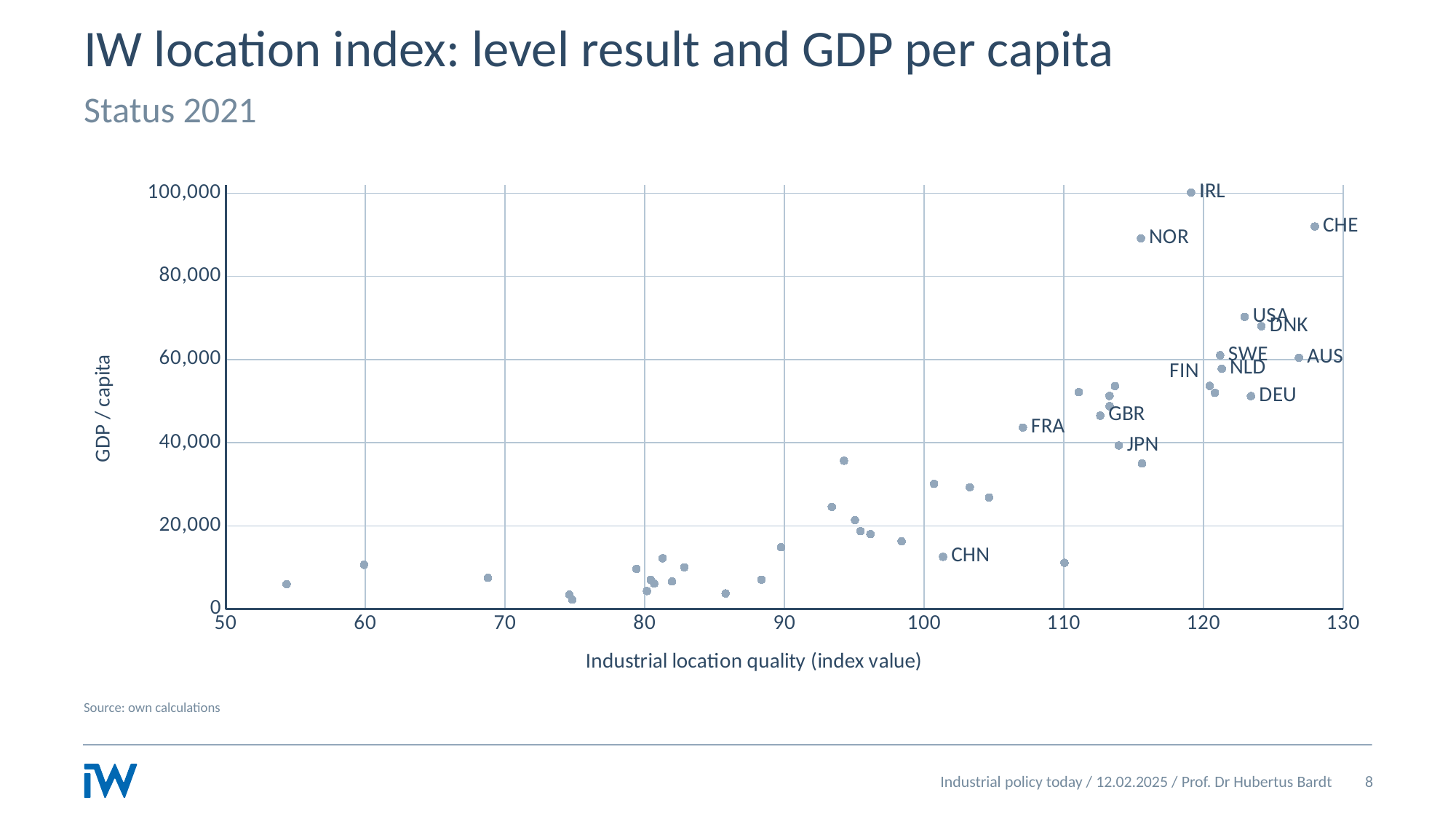
Which labelled country has the highest industrial location quality index value? CHE Is the GDP per capita for DEU greater or less than 60,000? less Is the GDP per capita for CHN greater or less than 20,000? less Which has the higher GDP per capita, IRL or NOR? IRL Which labelled country has the lowest GDP per capita? CHN Does GDP per capita generally rise or fall as the industrial location quality index value increases? rise What kind of chart is shown on the slide? scatter chart What is the label of the x axis? Industrial location quality (index value) Which labelled country has the highest GDP per capita? IRL Which has the higher GDP per capita, USA or GBR? USA Is the GDP per capita for CHE greater or less than 80,000? greater